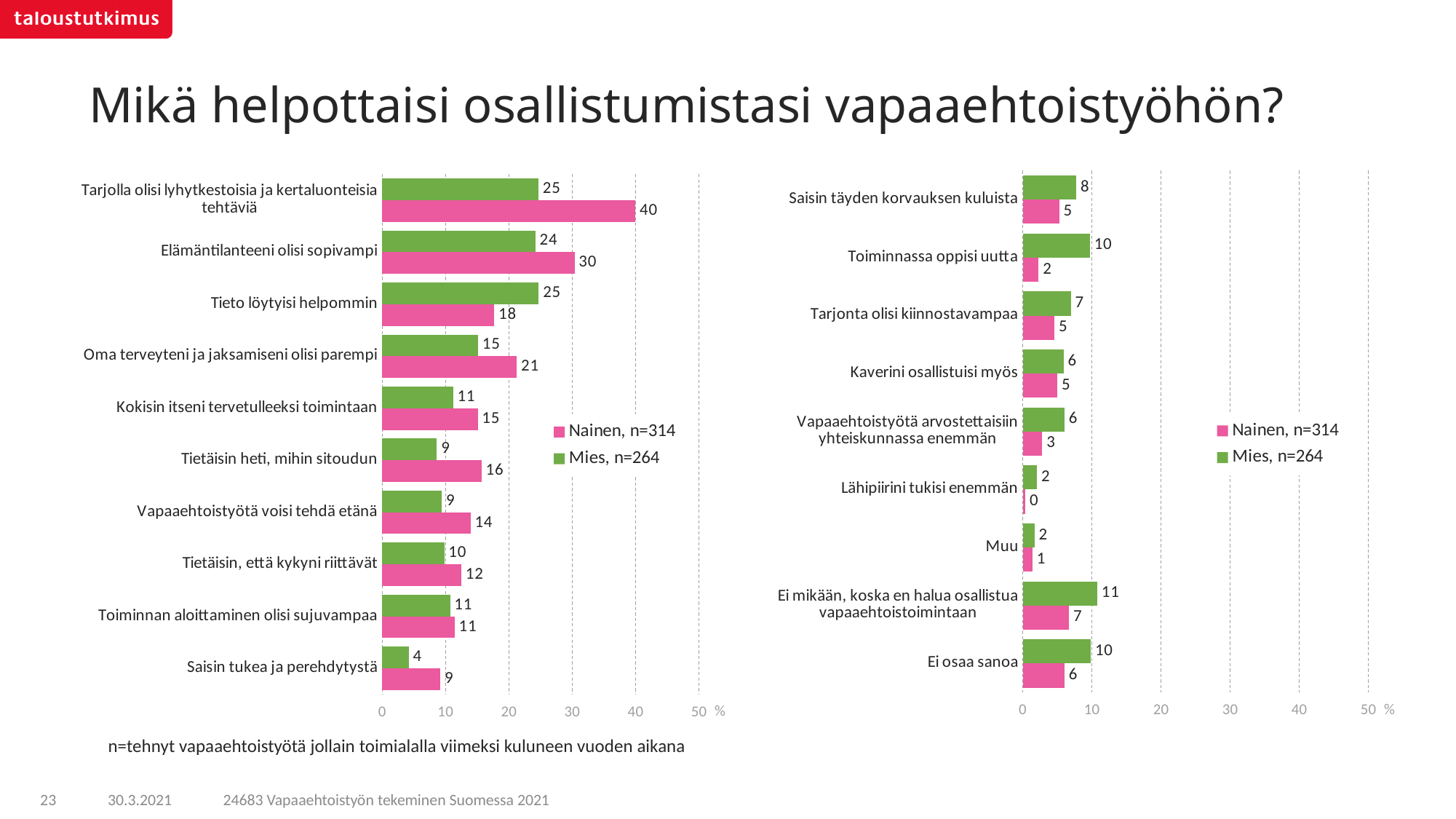
In the left chart, which category has the highest value for Nainen? Tarjolla olisi lyhytkestoisia ja kertaluonteisia tehtäviä In the left chart, for 'Tieto löytyisi helpommin', which is larger: the Nainen value or the Mies value? Mies In the left chart, what is the difference between the Nainen and Mies values for 'Elämäntilanteeni olisi sopivampi'? 6 In the left chart, what is the value for Mies for 'Tieto löytyisi helpommin'? 25 In the right chart, what is the value for Nainen for 'Lähipiirini tukisi enemmän'? 0 How many categories does the left chart show? 10 In the left chart, what is the value for Nainen for 'Tarjolla olisi lyhytkestoisia ja kertaluonteisia tehtäviä'? 40 In the right chart, what is the value for Mies for 'Toiminnassa oppisi uutta'? 10 In the right chart, which category has the highest value for Mies? Ei mikään, koska en halua osallistua vapaaehtoistoimintaan In the left chart, which category has the lowest value for Mies? Saisin tukea ja perehdytystä What type of chart is the left chart? Bar chart How many series does the legend of the right chart list? 2